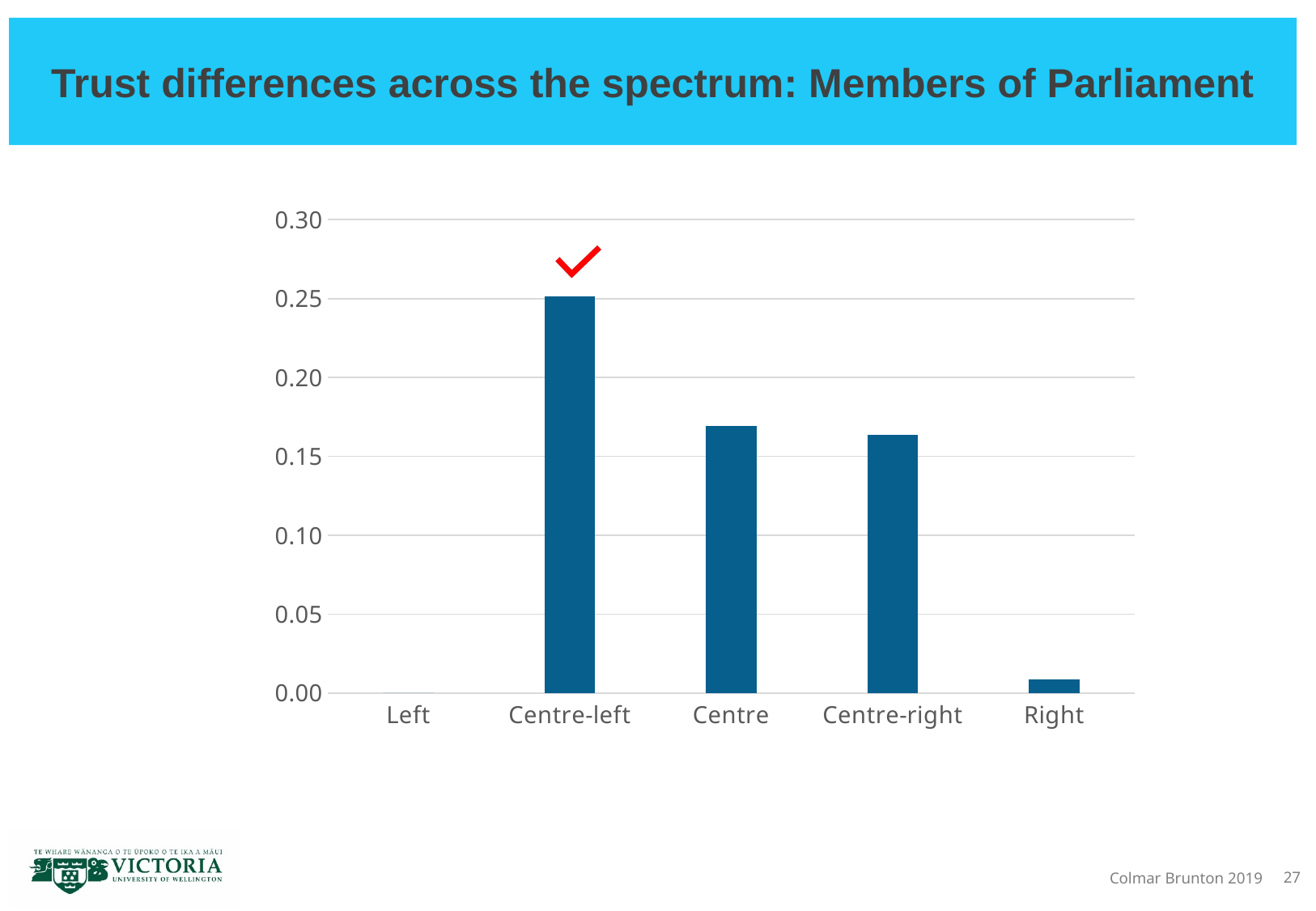
How many categories are shown on the x axis of the chart? 5 Which is larger, the value for Centre-left or the value for Centre? Centre-left Is the value for Right greater or less than 0.05? less Which is larger, the value for Centre-right or the value for Right? Centre-right Which category has the lowest value in the chart? Left Is the value for Centre greater or less than 0.20? less Above which category's bar is a red check mark drawn? Centre-left Is the value for Centre-left greater or less than 0.20? greater What is the title of the slide containing the chart? Trust differences across the spectrum: Members of Parliament What kind of chart is shown on the slide? bar chart Which category has the highest value in the chart? Centre-left